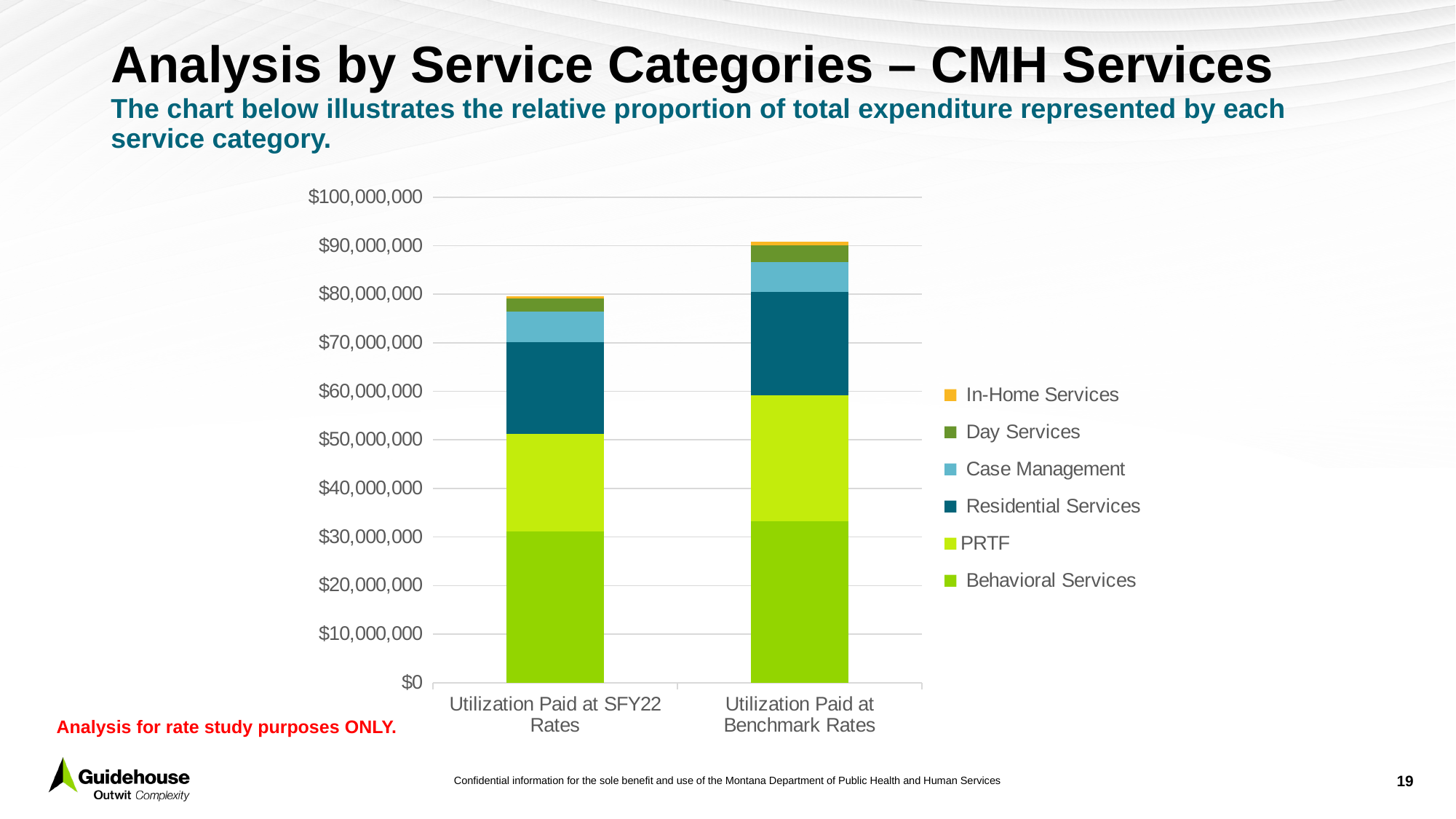
Which series forms the smallest segment of the Utilization Paid at Benchmark Rates bar? In-Home Services Is the total of the Utilization Paid at Benchmark Rates bar greater or less than $100,000,000? less Which series is shown in orange in the legend? In-Home Services Which series forms the largest segment of the Utilization Paid at SFY22 Rates bar? Behavioral Services Which bar is taller, Utilization Paid at SFY22 Rates or Utilization Paid at Benchmark Rates? Utilization Paid at Benchmark Rates Is the Behavioral Services value for Utilization Paid at SFY22 Rates greater or less than $40,000,000? less Is the total of the Utilization Paid at Benchmark Rates bar greater or less than $80,000,000? greater What kind of chart is shown on the slide? Stacked bar chart How many series does the legend list? 6 How many bars (categories) are plotted on the x axis? 2